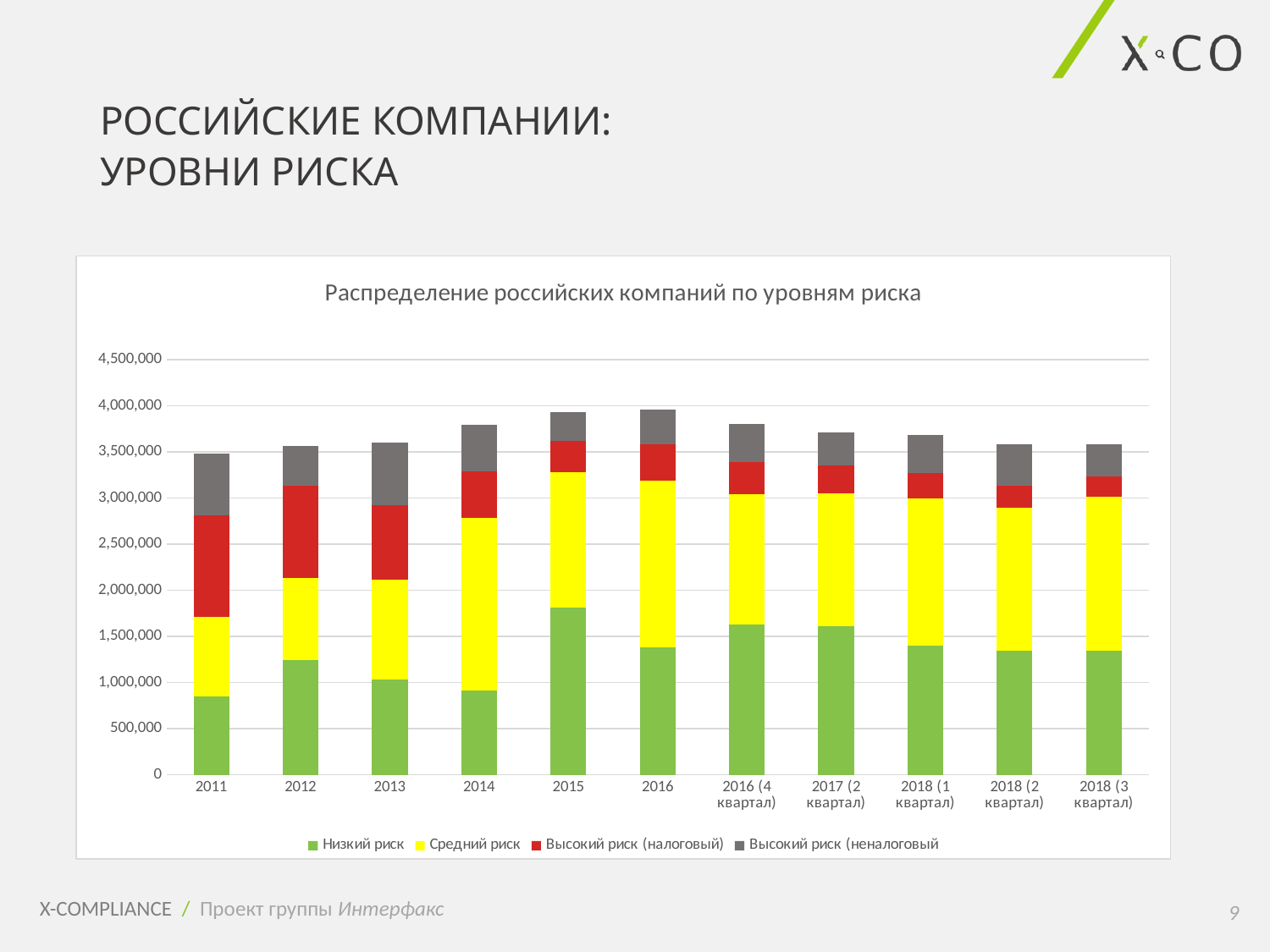
Is the value for Низкий риск in 2015 greater or less than 1,500,000? greater Is the total height of the stacked bar for 2016 greater or less than 4,000,000? less How many categories are shown on the x axis? 11 Which colour represents the series Низкий риск? Green Which is larger, the value for Низкий риск in 2015 or in 2016? 2015 Which category has the lowest total stacked bar? 2011 Is the value for Низкий риск in 2011 greater or less than 1,000,000? less How many series does the legend list? 4 What kind of chart is shown on the slide? Stacked bar chart Which category has the highest value for Низкий риск? 2015 What is the title of the chart? Распределение российских компаний по уровням риска